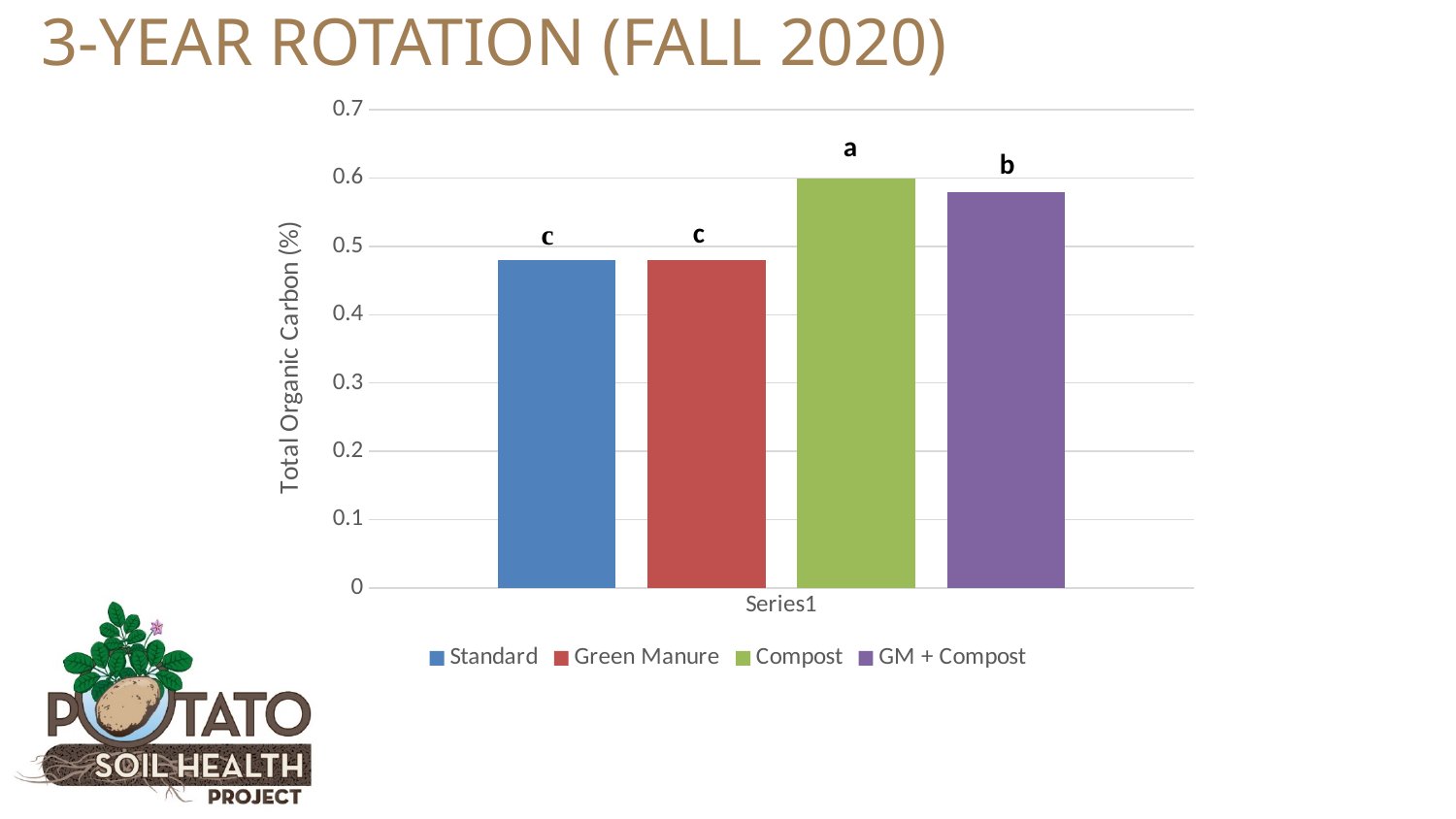
Is the value for GM + Compost greater or less than 0.5? greater What is the label on the y axis? Total Organic Carbon (%) Which is larger, the value for Compost or the value for Standard? Compost What kind of chart is shown on the slide? bar chart How many categories are shown on the x axis? 1 Is the value for Green Manure greater or less than 0.5? less Is the value for Standard greater or less than 0.5? less Which treatment has the highest Total Organic Carbon? Compost What letter is printed above the Compost bar? a Which is larger, the value for GM + Compost or the value for Green Manure? GM + Compost How many series does the legend list? 4